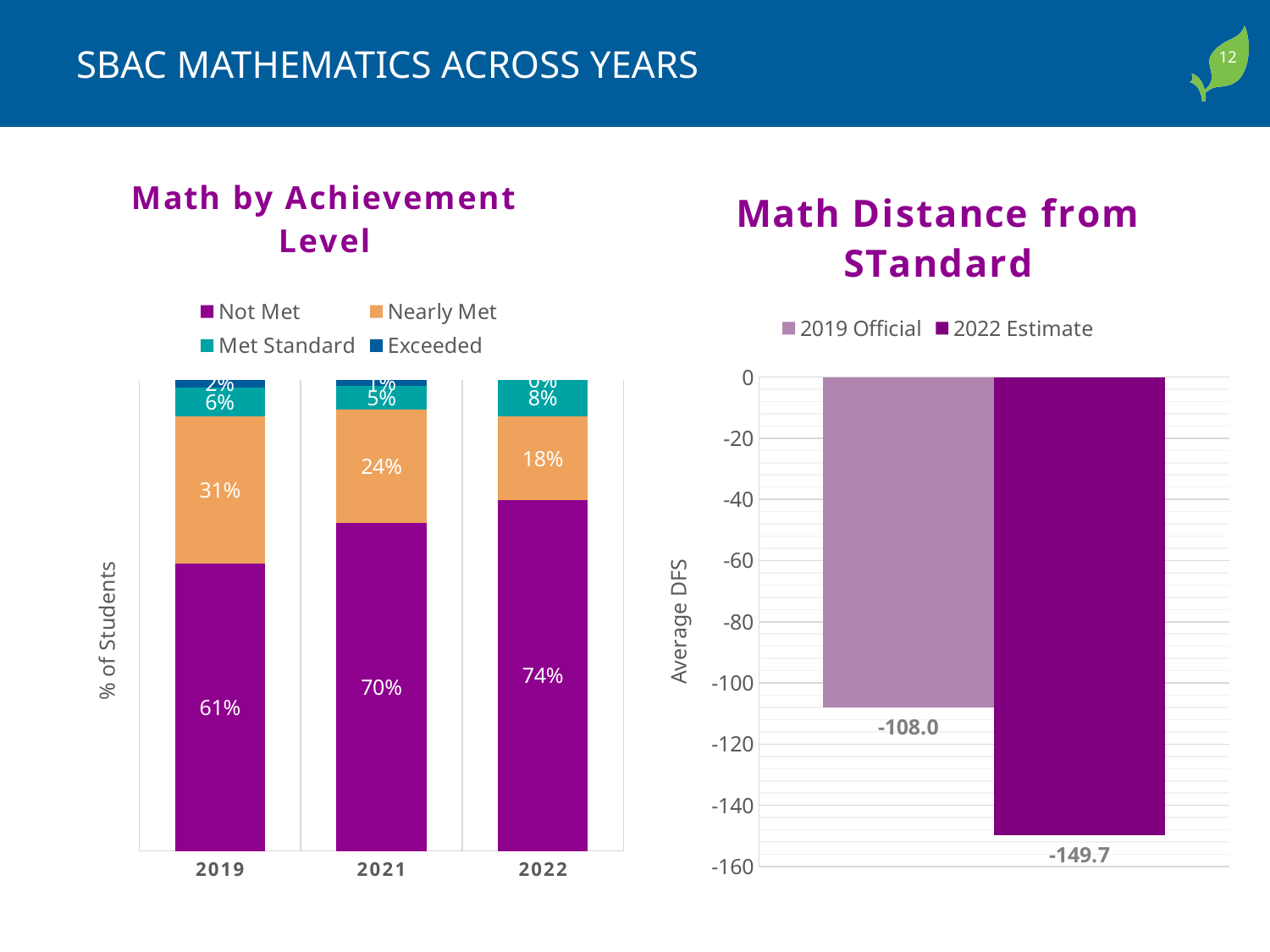
What kind of chart is 'Math Distance from STandard'? bar chart In the 'Math by Achievement Level' chart, what percentage of students were in the Not Met level in 2019? 61% In the 'Math by Achievement Level' chart, which year has the highest Not Met percentage? 2022 In the 'Math Distance from STandard' chart, what is the value for 2022 Estimate? -149.7 In the 'Math Distance from STandard' chart, what is the value for 2019 Official? -108.0 In the 'Math by Achievement Level' chart, what is the difference between the Not Met percentage in 2022 and in 2019? 13% In the 'Math by Achievement Level' chart, does the Not Met percentage rise or fall from 2019 to 2022? rise In the 'Math by Achievement Level' chart, how many series does the legend list? 4 In the 'Math by Achievement Level' chart, what percentage of students Met Standard in 2021? 5% In the 'Math Distance from STandard' chart, what is the difference between the 2019 Official and 2022 Estimate values? 41.7 In the 'Math by Achievement Level' chart, what percentage of students were in the Nearly Met level in 2022? 18% In the 'Math by Achievement Level' chart, which year has the lowest Nearly Met percentage? 2022